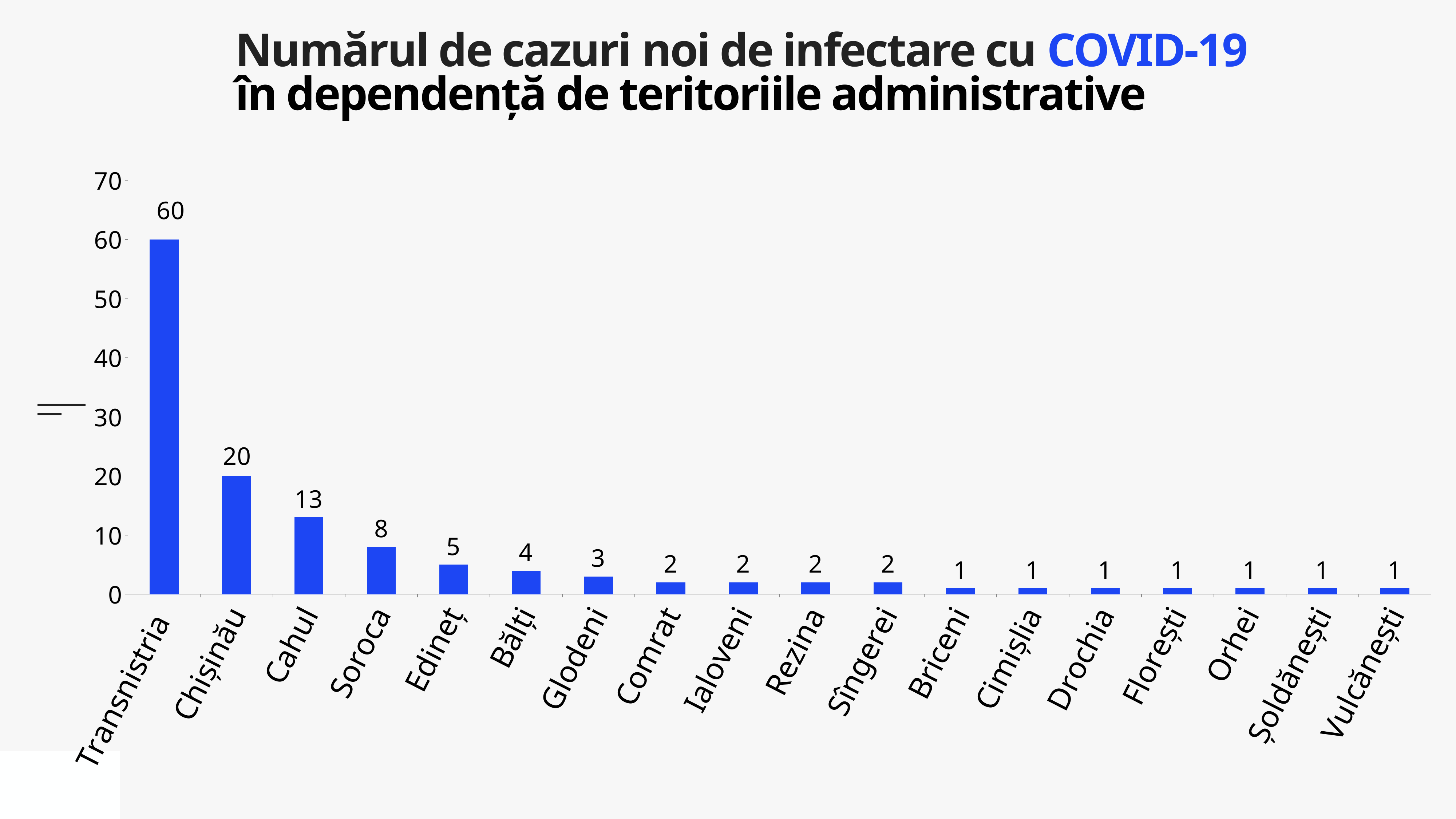
Is the value for Cahul greater or less than 10? greater What is the value for Transnistria? 60 How many categories are shown on the x axis? 18 What is the value for Soroca? 8 What is the difference between the values for Transnistria and Chișinău? 40 What kind of chart is shown on the slide? bar chart Which category has the highest value? Transnistria Which is larger, the value for Edineț or the value for Bălți? Edineț What is the value for Glodeni? 3 What is the value for Chișinău? 20 What is the difference between the values for Cahul and Soroca? 5 Do the values rise or fall from left to right along the x axis? fall